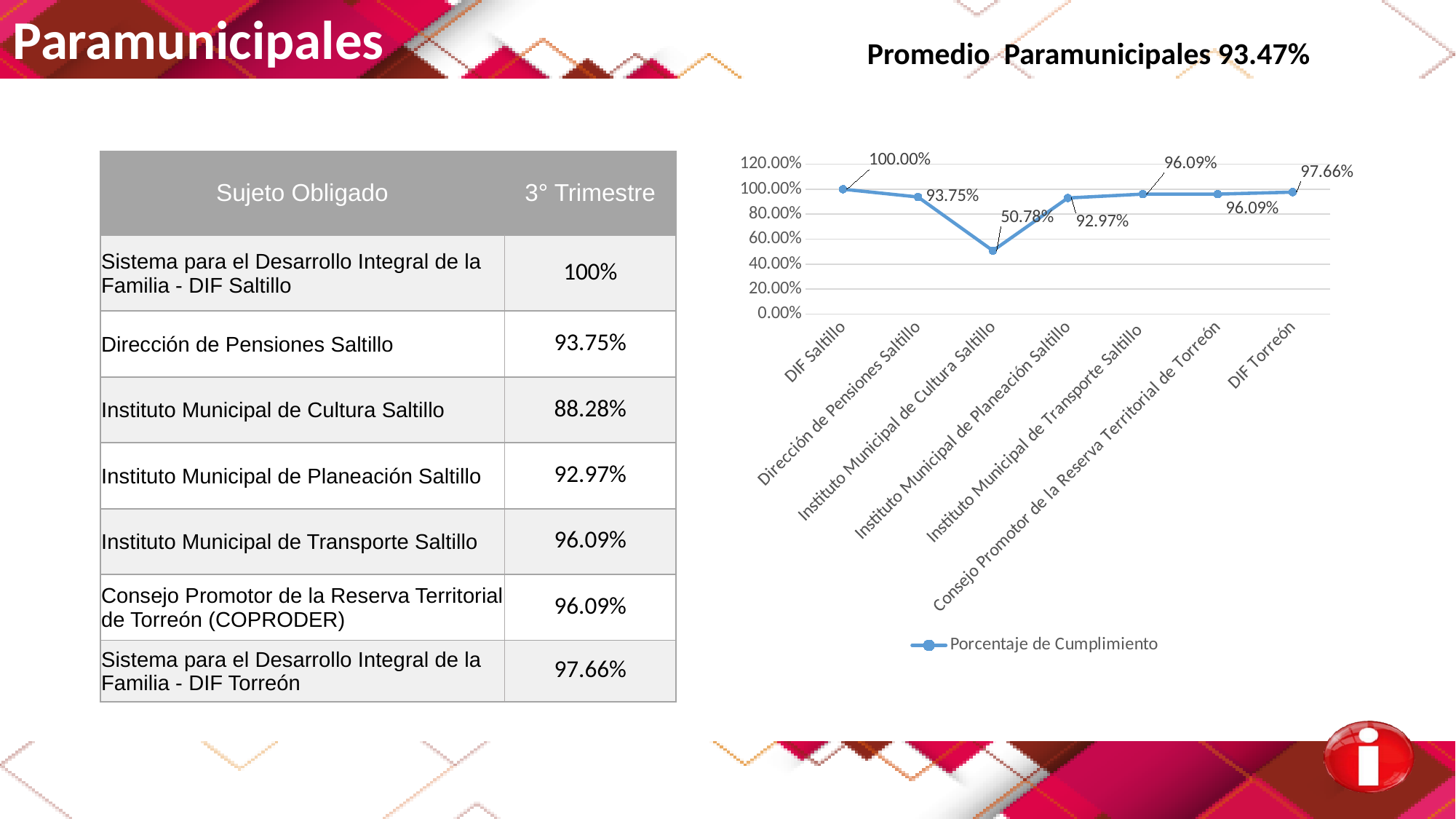
What is the difference between the values for DIF Saltillo and Dirección de Pensiones Saltillo in the chart? 6.25% In the chart, what is the value for Instituto Municipal de Cultura Saltillo? 50.78% In the chart, what is the value for DIF Saltillo? 100.00% What kind of chart is shown on the slide? line chart What is the name of the series shown in the chart legend? Porcentaje de Cumplimiento How many series does the chart legend list? 1 In the chart, what is the value for DIF Torreón? 97.66% Which category has the highest value in the chart? DIF Saltillo Which category has the lowest value in the chart? Instituto Municipal de Cultura Saltillo In the chart, what is the value for Instituto Municipal de Planeación Saltillo? 92.97% How many categories are plotted on the x axis of the chart? 7 In the chart, which is larger: the value for DIF Torreón or the value for Instituto Municipal de Planeación Saltillo? DIF Torreón